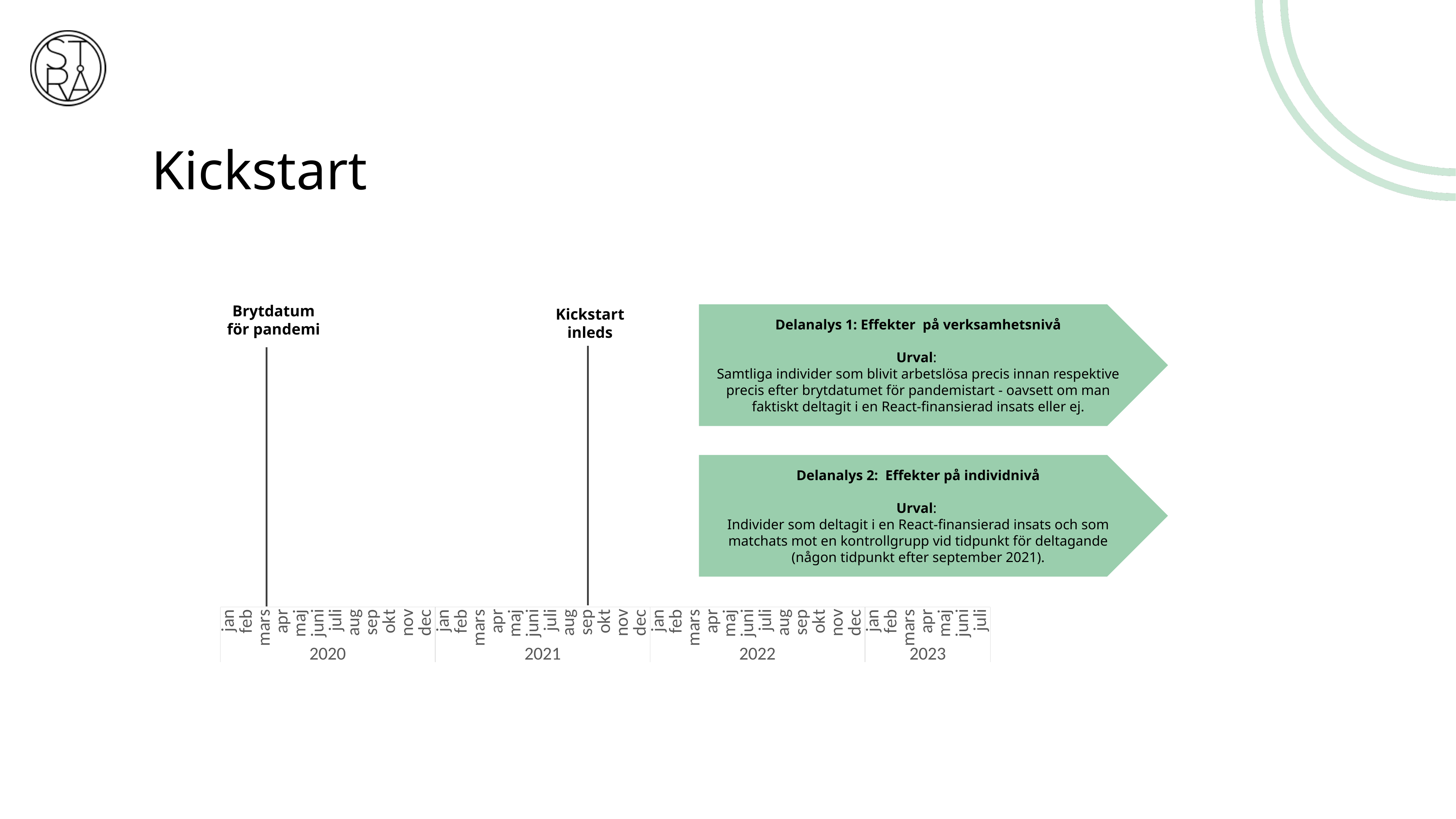
What is the first month shown on the timeline axis? jan 2020 How many year labels appear on the timeline axis? 4 What is the title of the slide containing the timeline? Kickstart What is the last month shown on the timeline axis? juli 2023 How many months are shown for 2023 on the timeline axis? 7 Which marker comes earlier on the timeline, 'Brytdatum för pandemi' or 'Kickstart inleds'? Brytdatum för pandemi Which years are labelled along the timeline axis? 2020, 2021, 2022, 2023 At which month and year does the 'Brytdatum för pandemi' marker line land on the axis? mars 2020 At which month and year does the 'Kickstart inleds' marker line land on the axis? sep 2021